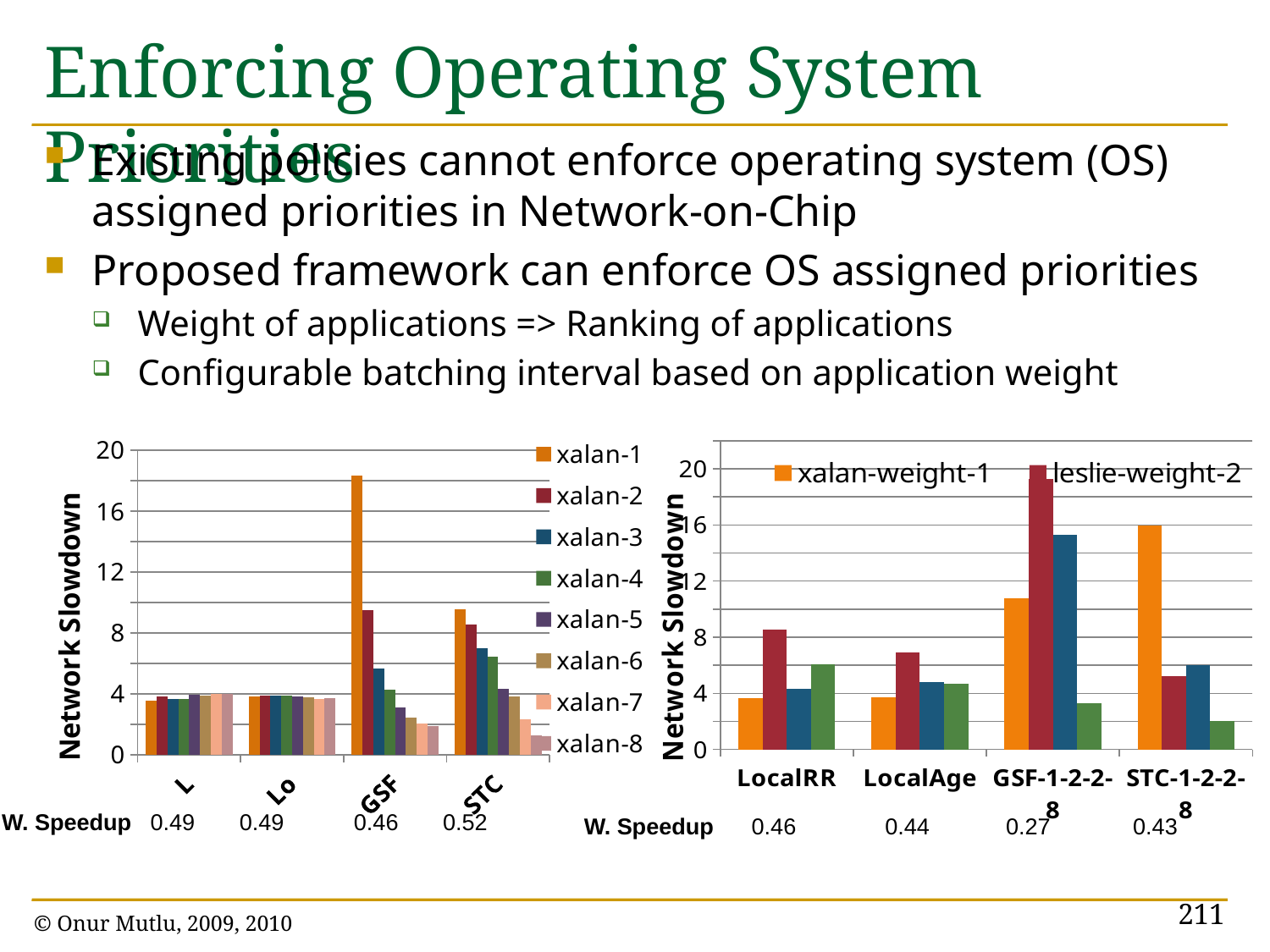
In the left chart, is the xalan-8 value for STC greater or less than 4? less What kind of chart is the left chart on the slide? bar chart In the right chart, which category has the highest xalan-weight-1 bar? STC-1-2-2-8 What is the y-axis title of the left chart? Network Slowdown In the left chart, which category has the highest xalan-1 bar? GSF In the right chart, for LocalRR, which is larger: xalan-weight-1 or leslie-weight-2? leslie-weight-2 How many categories are shown on the x axis of the right chart? 4 In the right chart, is the leslie-weight-2 value for GSF-1-2-2-8 greater or less than 16? greater How many series does the legend of the left chart list? 8 In the right chart, is the xalan-weight-1 value for GSF-1-2-2-8 greater or less than 8? greater